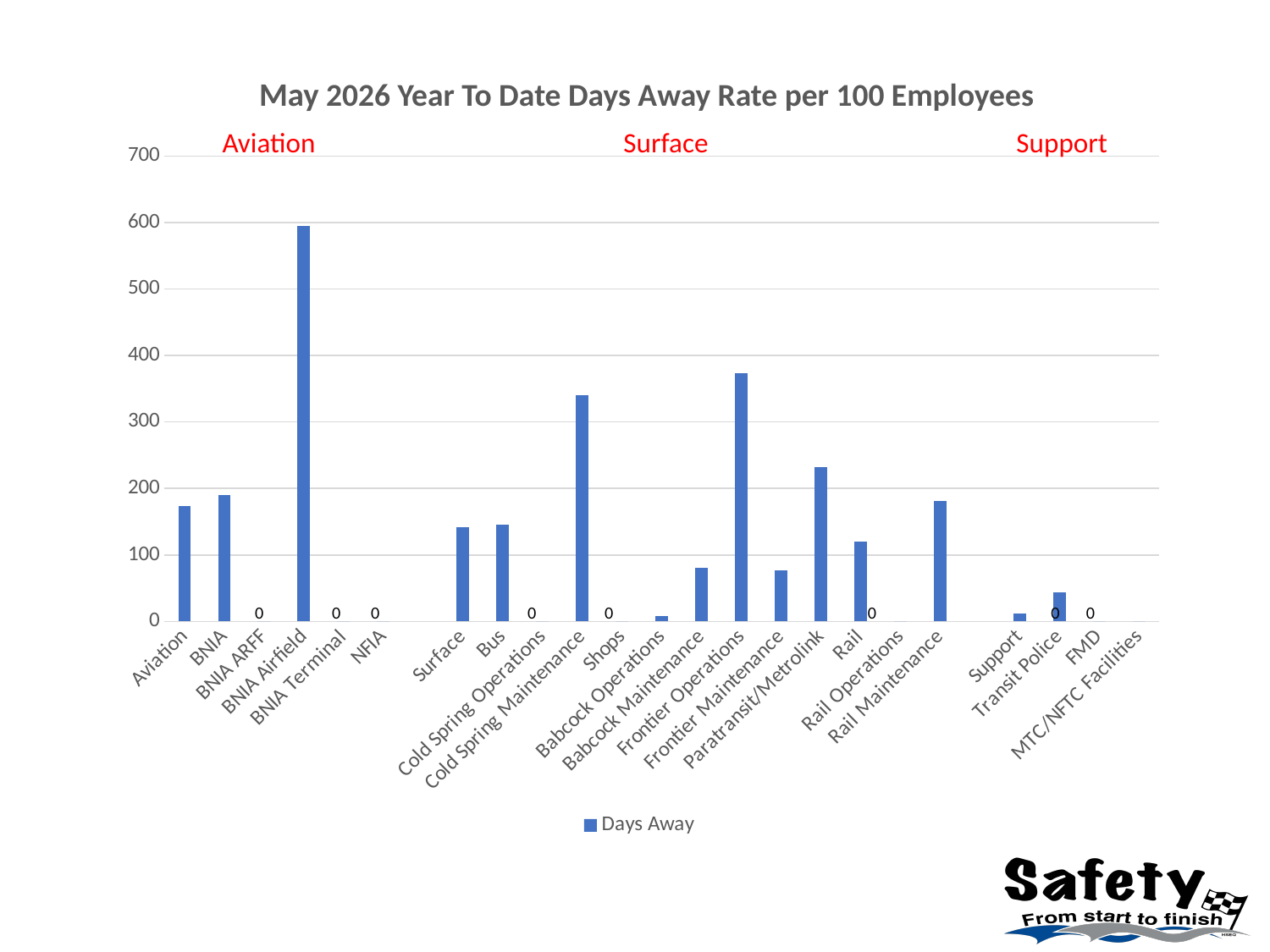
What kind of chart is shown on the slide? bar chart Is the value for Babcock Maintenance greater or less than 100? less What are the three red group headings shown above the chart? Aviation, Surface, Support Is the value for BNIA Airfield greater or less than 500? greater Which category has the highest Days Away rate? BNIA Airfield What is the title of the chart? May 2026 Year To Date Days Away Rate per 100 Employees What is the Days Away value for BNIA ARFF? 0 Is the value for Frontier Operations greater or less than 300? greater How many series does the legend list? 1 Which is larger, the value for Frontier Operations or the value for Cold Spring Maintenance? Frontier Operations What is the Days Away value for Shops? 0